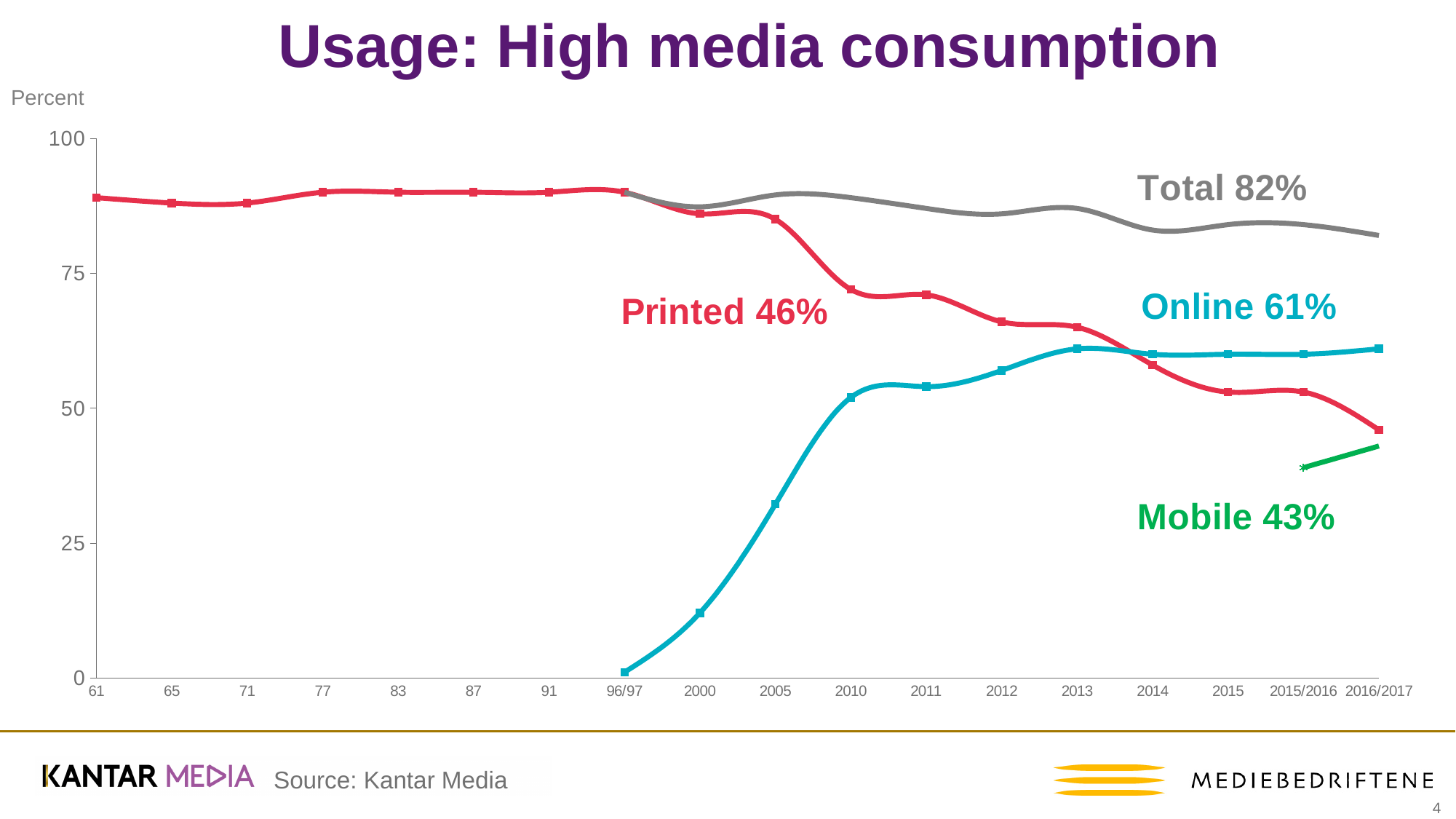
Is the value for Online in 2000 greater or less than 25? less What is the value for Online at the end of the series (2016/2017)? 61% What kind of chart is shown on the slide? line chart What is the value for Printed at the end of the series (2016/2017)? 46% What is the value for Mobile at the end of the series (2016/2017)? 43% In 2016/2017, which is larger: Online or Printed? Online Which series has the highest value in 2016/2017? Total What is the difference between the Online value (61%) and the Printed value (46%) in 2016/2017? 15 percentage points What is the value for Total at the end of the series (2016/2017)? 82% What unit label is shown above the y axis? Percent Which series has the lowest value in 2016/2017? Mobile Does the Printed series rise or fall from 96/97 to 2016/2017? fall